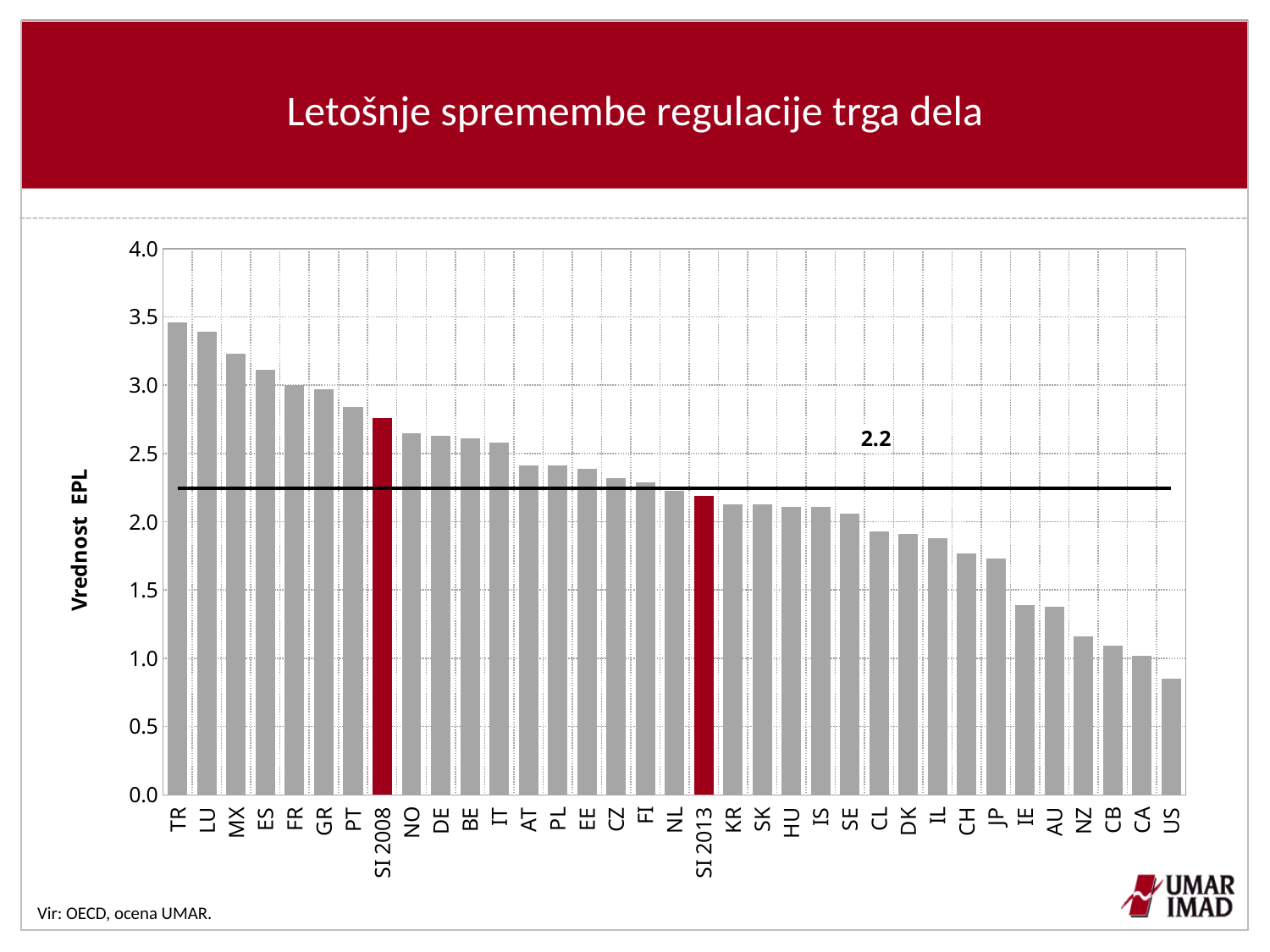
Is the value for SI 2013 greater or less than 2.5? less How many bars (categories) are plotted in the chart? 35 Which has the larger value, SI 2008 or SI 2013? SI 2008 Which category has the lowest value in the chart? US Is the value for TR greater or less than 3.0? greater Is the value for SI 2008 greater or less than 2.5? greater What kind of chart is shown on the slide? bar chart What value is labelled on the horizontal reference line in the chart? 2.2 What is the label of the vertical axis of the chart? Vrednost EPL Which category has the highest value in the chart? TR Do the bar values rise or fall moving from left to right along the x axis? fall